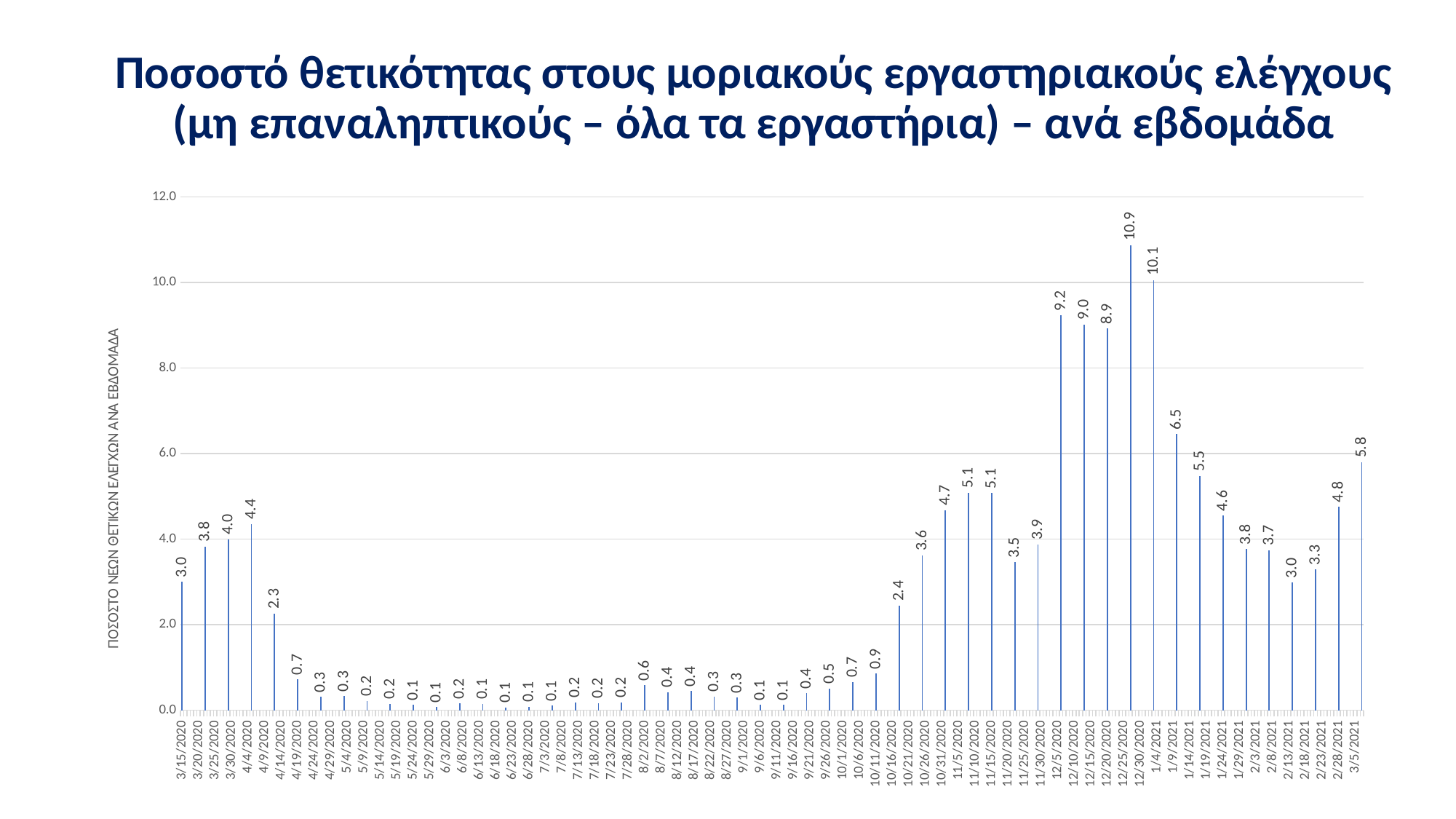
What is the highest value shown in the chart? 10.9 What is the difference between the two highest values, 10.9 and 10.1? 0.8 What is the value for the first week, 3/15/2020? 3.0 What is the difference between the value for 3/5/2021 and the value for 3/15/2020? 2.8 Do the values rise or fall over the first four weeks, from 3/15/2020 to 3/30/2020? rise Which is larger, the bar labelled 9.2 or the bar labelled 8.9? 9.2 Is the highest bar greater or less than 10.0? greater How many bars exceed 10.0? 2 What kind of chart is shown on the slide? bar chart What is the value for the last week, 3/5/2021? 5.8 What is the lowest value shown in the chart? 0.1 What is the highest tick value shown on the y axis? 12.0